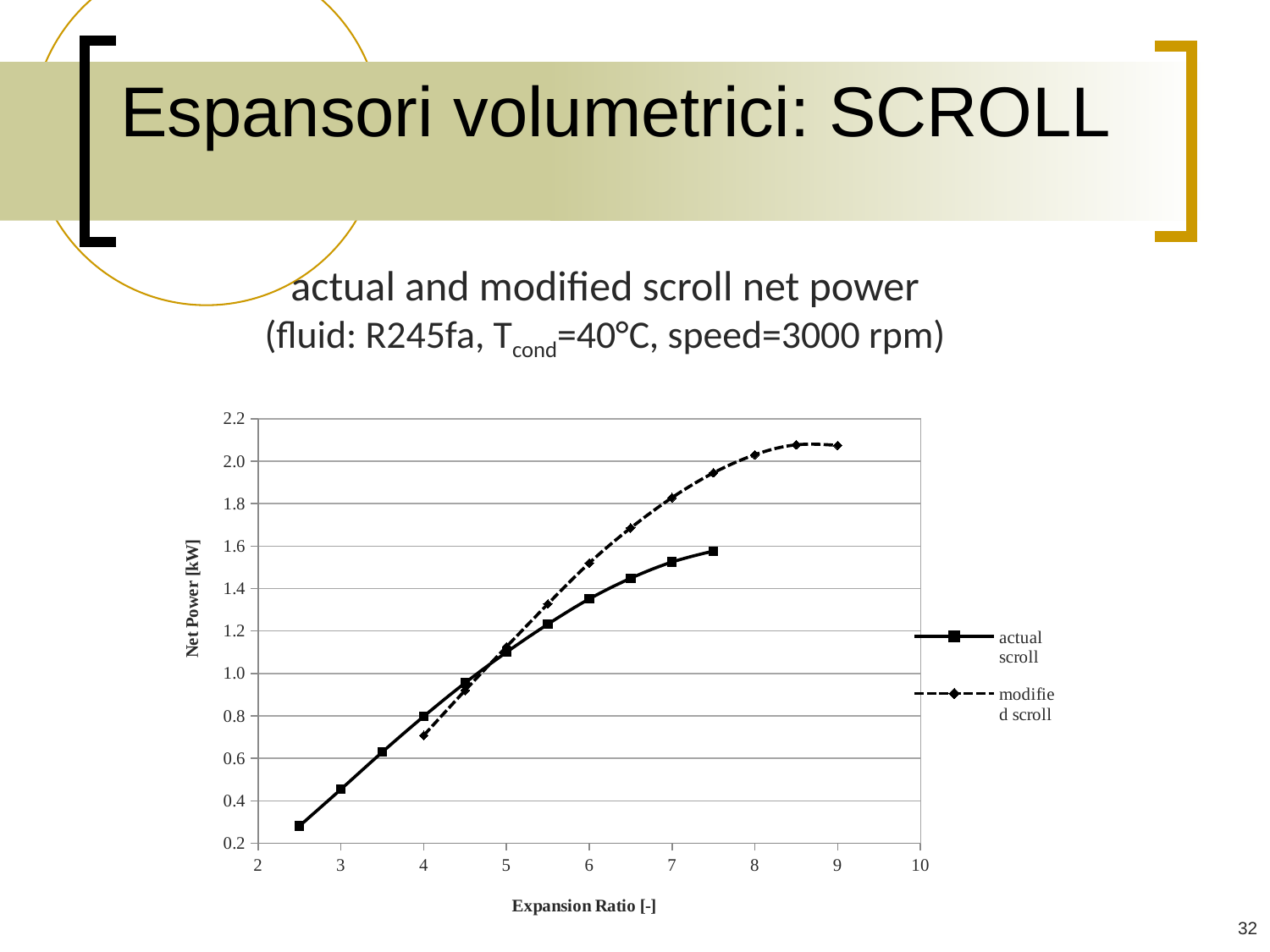
At an expansion ratio of 4, which series has the larger net power, actual scroll or modified scroll? actual scroll At an expansion ratio of 7, which series has the larger net power, actual scroll or modified scroll? modified scroll Is the net power of the actual scroll at an expansion ratio of 3 greater or less than 0.6 kW? less What kind of chart is shown on the slide? line chart How many data points are plotted for the actual scroll series? 11 Does the net power of the actual scroll rise or fall as the expansion ratio increases? rise Is the net power of the modified scroll at an expansion ratio of 4 greater or less than 0.8 kW? less What are the two series named in the legend? actual scroll, modified scroll What is the label of the x axis? Expansion Ratio [-] How many series does the legend list? 2 Is the net power of the modified scroll at an expansion ratio of 9 greater or less than 2.0 kW? greater Which series reaches the highest net power on the chart? modified scroll